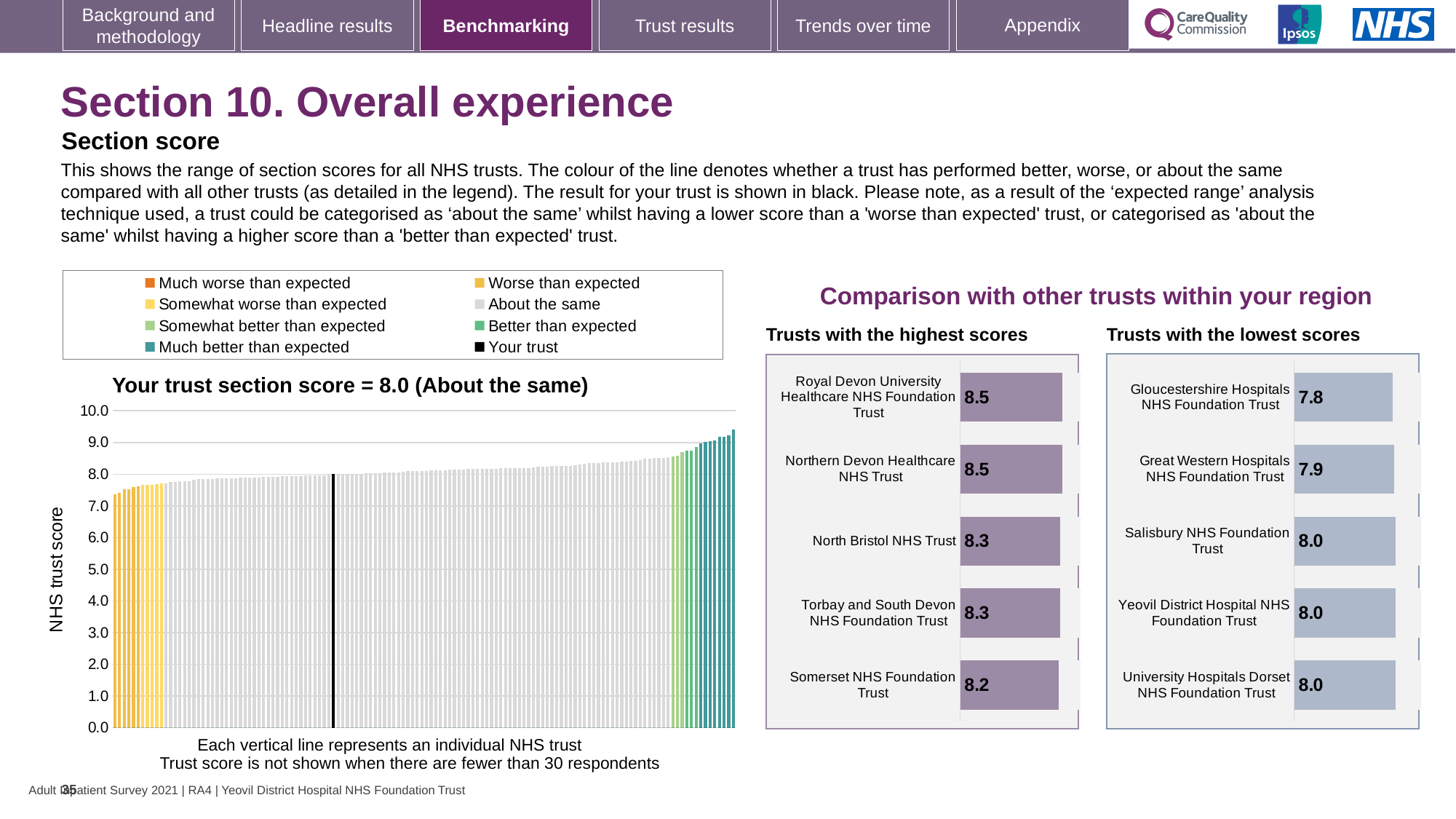
How many entries does the legend above the 'Your trust section score' chart list? 8 In the 'Trusts with the lowest scores' chart, which trust has the lowest score? Gloucestershire Hospitals NHS Foundation Trust What is the difference between the score for Royal Devon University Healthcare NHS Foundation Trust in the highest scores chart and the score for Gloucestershire Hospitals NHS Foundation Trust in the lowest scores chart? 0.7 In the 'Trusts with the highest scores' chart, which has the higher score: North Bristol NHS Trust or Somerset NHS Foundation Trust? North Bristol NHS Trust How many trusts are shown in the 'Trusts with the lowest scores' chart? 5 In the 'Trusts with the highest scores' chart, which trust has the lowest score? Somerset NHS Foundation Trust In the 'Trusts with the lowest scores' chart, what is the difference between the scores for Great Western Hospitals NHS Foundation Trust and Gloucestershire Hospitals NHS Foundation Trust? 0.1 In the 'Trusts with the highest scores' chart, what is the score for North Bristol NHS Trust? 8.3 In the 'Trusts with the lowest scores' chart, what is the score for Gloucestershire Hospitals NHS Foundation Trust? 7.8 In the 'Your trust section score' chart on the left, do the trust scores rise or fall from left to right along the x axis? Rise In the 'Trusts with the highest scores' chart, what is the score for Somerset NHS Foundation Trust? 8.2 What kind of chart is the 'Your trust section score' chart on the left? Bar chart